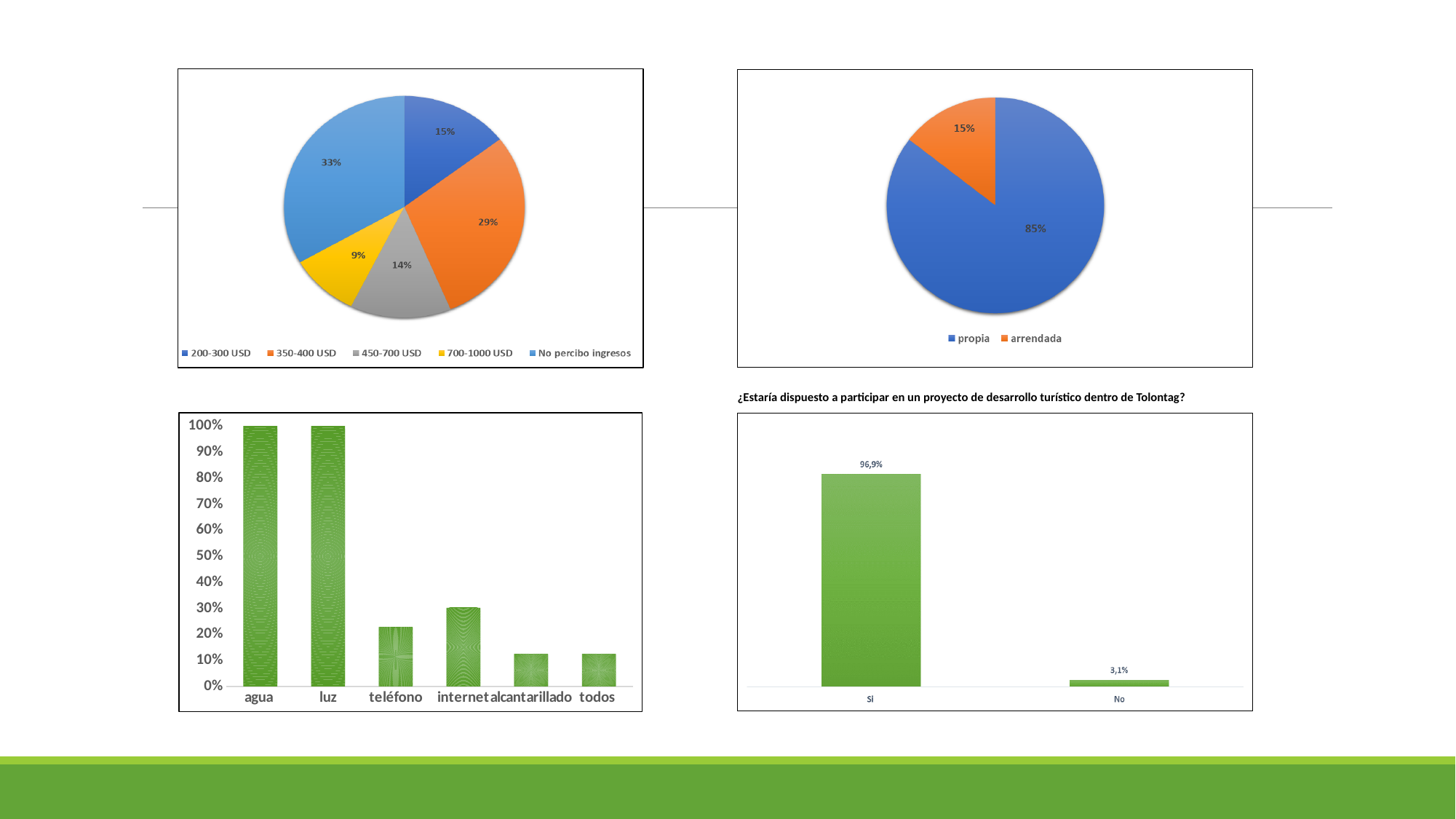
What kind of chart is the one titled '¿Estaría dispuesto a participar en un proyecto de desarrollo turístico dentro de Tolontag?'? bar chart In the top-left pie chart, which category has the largest slice? No percibo ingresos In the top-left pie chart, how many categories does the legend list? 5 In the top-right pie chart, what share is shown for 'propia'? 85% In the top-right pie chart, what is the difference between the 'propia' and 'arrendada' shares? 70% In the top-left pie chart, what share is shown for the 350-400 USD slice? 29% In the top-left pie chart, which category has the smallest slice? 700-1000 USD In the bottom-left bar chart, which is larger, the value for internet or the value for alcantarillado? internet In the bottom-left bar chart, what value do the bars for agua and luz reach? 100% In the bottom-left bar chart, how many categories are shown on the x axis? 6 In the chart titled '¿Estaría dispuesto a participar en un proyecto de desarrollo turístico dentro de Tolontag?', what is the value for 'Si'? 96,9% In the bottom-left bar chart, is the value for teléfono greater or less than 30%? less